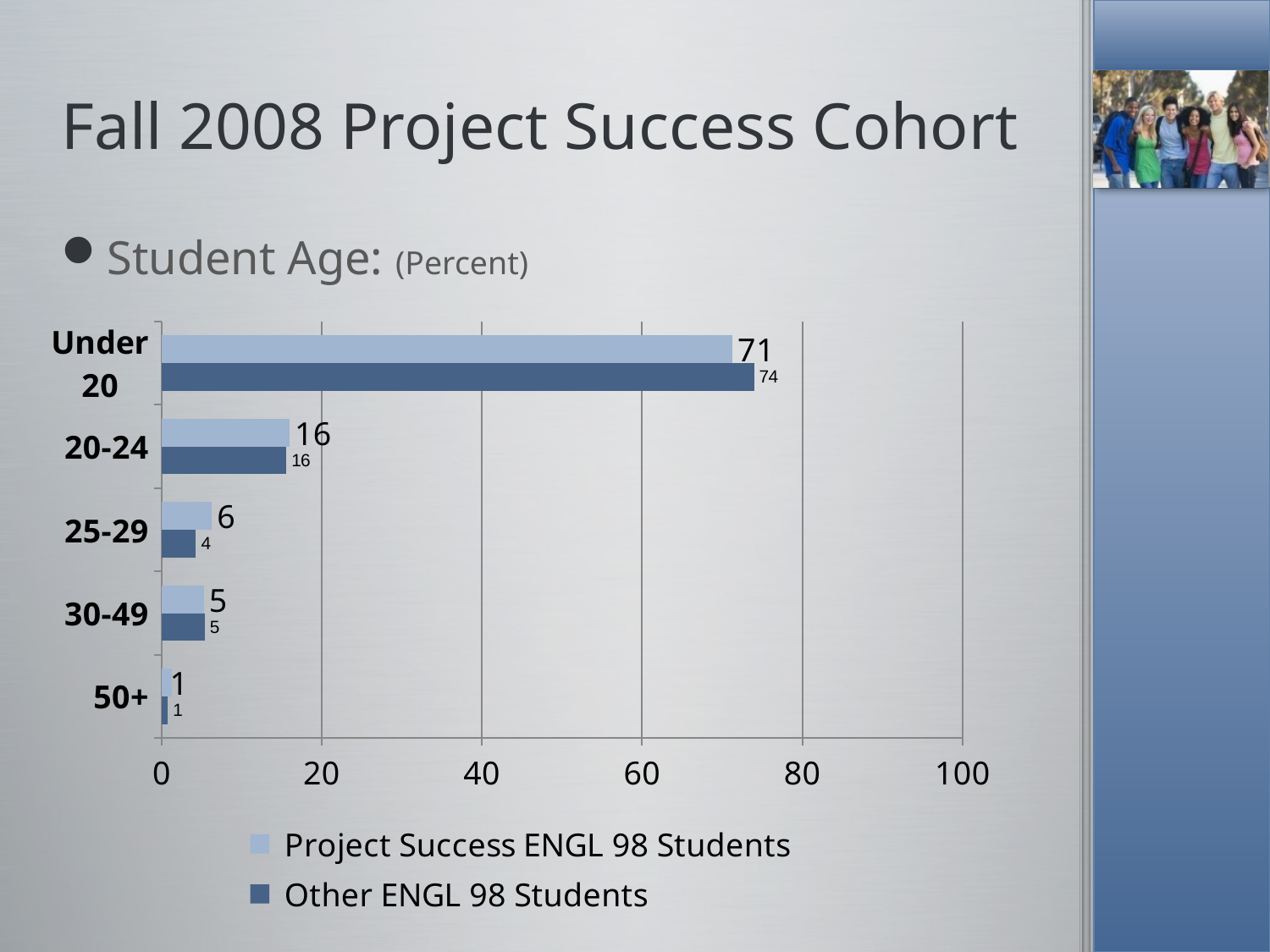
What is the value for Project Success ENGL 98 Students in the Under 20 age group? 71 What kind of chart is shown on the slide? bar chart What is the value for Project Success ENGL 98 Students in the 25-29 age group? 6 How many age groups are shown on the chart? 5 What is the difference between Other ENGL 98 Students and Project Success ENGL 98 Students in the Under 20 age group? 3 What is the value for Other ENGL 98 Students in the Under 20 age group? 74 How many series does the legend list? 2 Which age group has the lowest value for Other ENGL 98 Students? 50+ Is the value for Other ENGL 98 Students in the Under 20 age group greater or less than 60? greater What is the value for Other ENGL 98 Students in the 25-29 age group? 4 Which age group has the highest value for Project Success ENGL 98 Students? Under 20 In the 25-29 age group, which series has the larger value, Project Success ENGL 98 Students or Other ENGL 98 Students? Project Success ENGL 98 Students